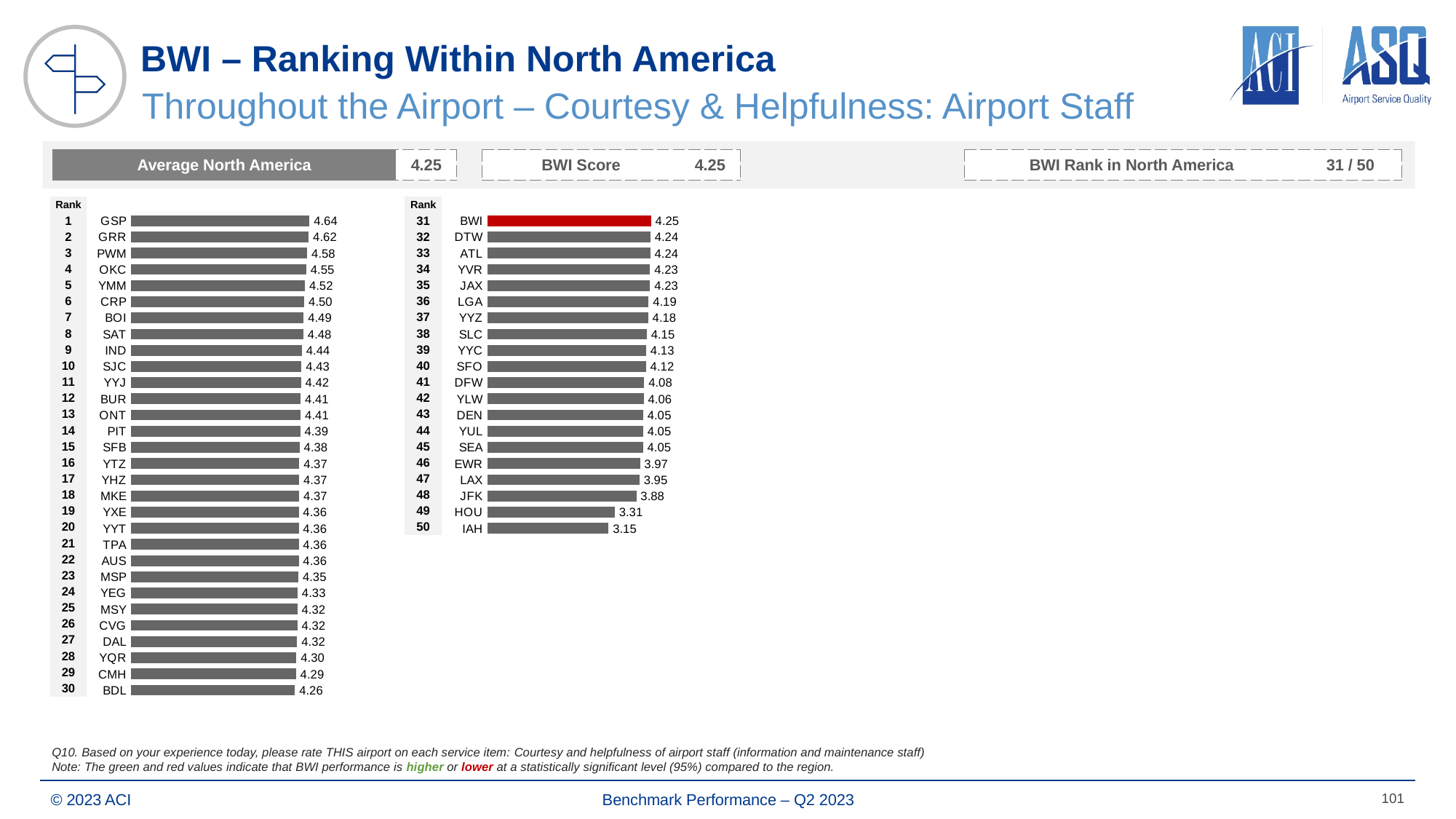
In the right chart (ranks 31-50), which has a higher score, HOU or LAX? LAX In the right chart (ranks 31-50), which airport has the lowest score? IAH In the left chart (ranks 1-30), what is the difference between the scores of GSP and BDL? 0.38 In the left chart (ranks 1-30), which airport has the highest score? GSP In the right chart (ranks 31-50), which airport's bar is coloured red? BWI In the left chart (ranks 1-30), what is the score for GSP? 4.64 In the right chart (ranks 31-50), what is the score for BWI? 4.25 In the right chart (ranks 31-50), what is the score for JFK? 3.88 How many airports are shown in the left chart (ranks 1-30)? 30 In the right chart (ranks 31-50), what is the difference between the scores of BWI and IAH? 1.10 How many airports are shown in the right chart (ranks 31-50)? 20 What type of chart is used to show the airport scores? Bar chart